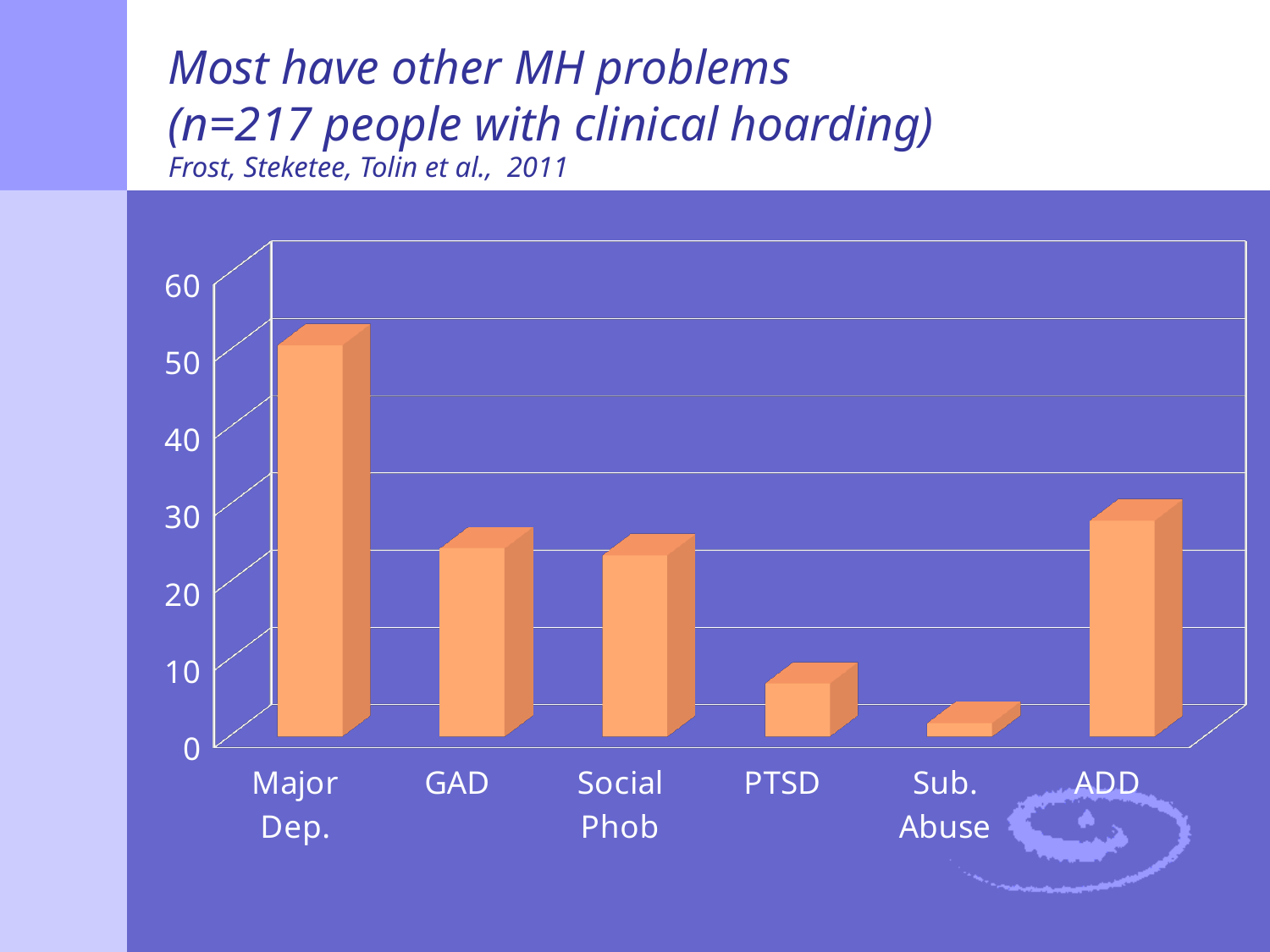
What is the title of the slide containing the chart? Most have other MH problems (n=217 people with clinical hoarding) Which is larger, the value for ADD or the value for PTSD? ADD Is the value for PTSD greater or less than 10? less Which category has the lowest bar in the chart? Sub. Abuse Is the value for ADD greater or less than 20? greater Is the value for GAD greater or less than 30? less How many categories are shown on the x axis of the chart? 6 What kind of chart is shown on the slide? Bar chart Which category has the highest bar in the chart? Major Dep. Which is larger, the value for Major Dep. or the value for GAD? Major Dep.